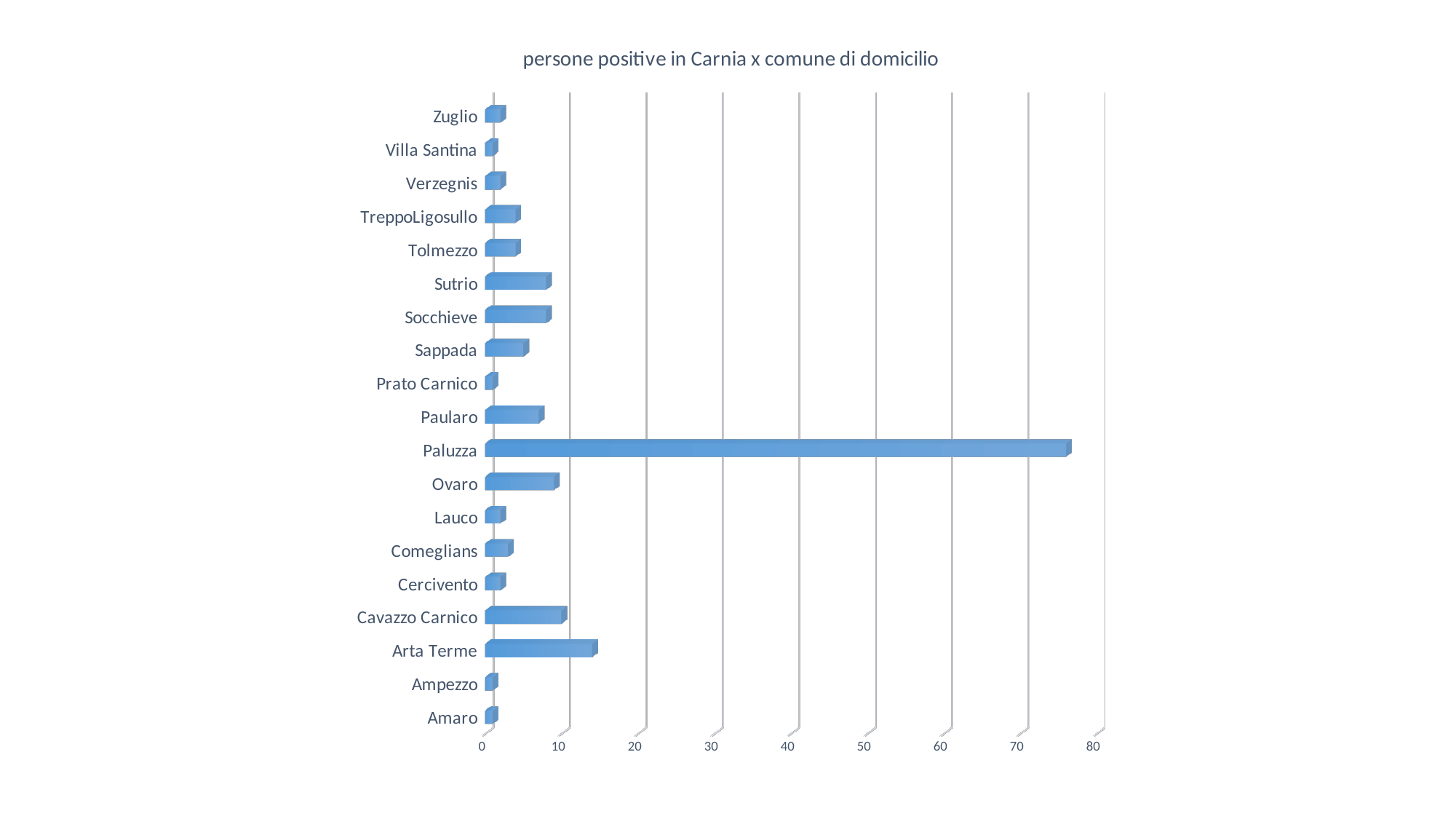
Is the value for Arta Terme greater or less than 10? greater Which comune has the highest number of positive persons? Paluzza Is the value for Sutrio greater or less than 10? less Is the value for Paluzza greater or less than 70? greater What is the highest value shown on the horizontal axis? 80 How many comuni (categories) are plotted in the chart? 19 What is the title of the chart? persone positive in Carnia x comune di domicilio Which has a larger value, Sutrio or Tolmezzo? Sutrio Which has a larger value, Arta Terme or Cavazzo Carnico? Arta Terme What kind of chart is shown on the slide? bar chart